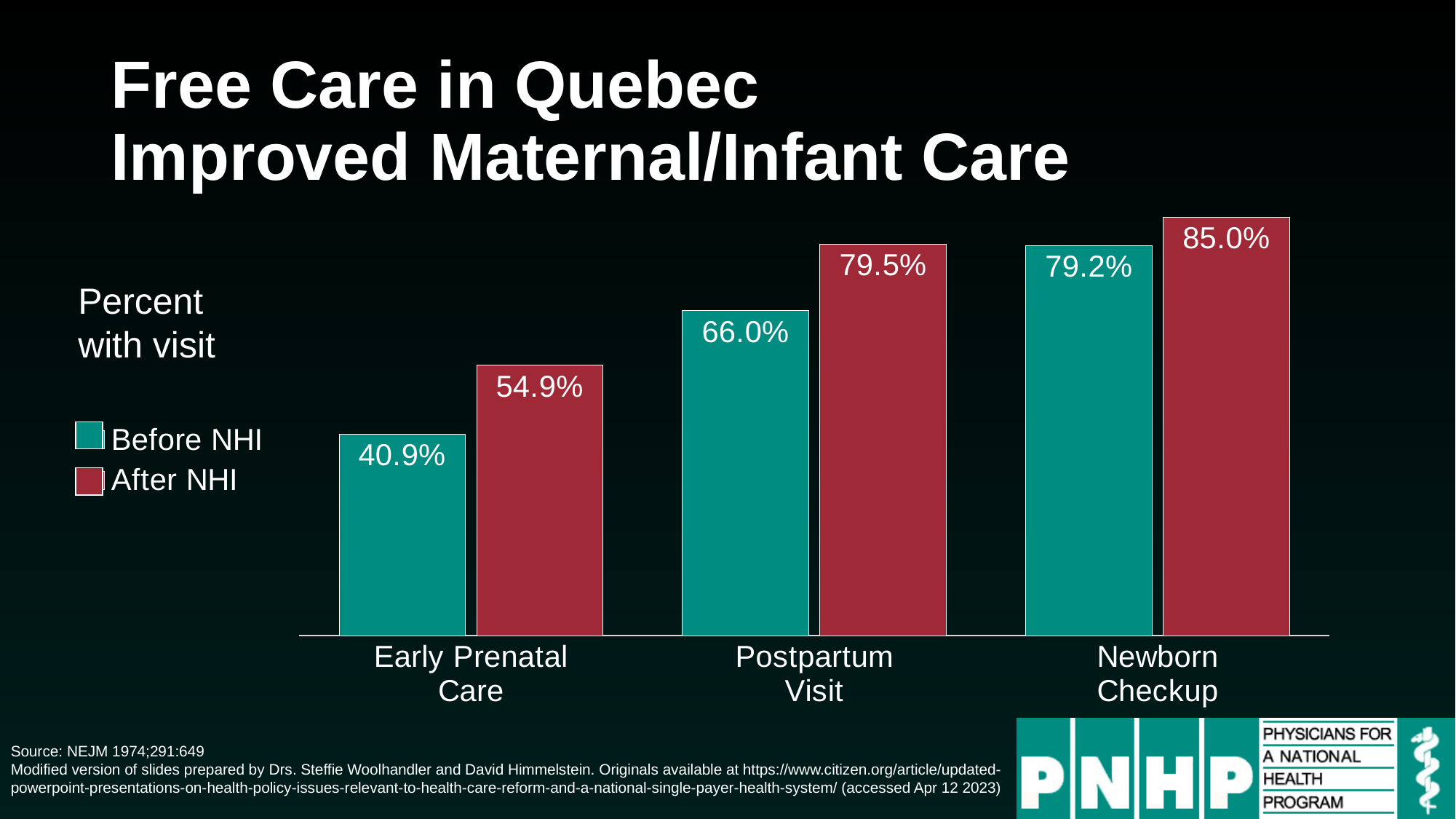
What is the Before NHI value for Early Prenatal Care? 40.9% What is the difference between the After NHI and Before NHI values for Postpartum Visit? 13.5% Which colour represents the After NHI series? Red Which category has the lowest Before NHI value? Early Prenatal Care What is the After NHI value for Postpartum Visit? 79.5% What is the After NHI value for Newborn Checkup? 85.0% Which is larger: the Before NHI value for Newborn Checkup or the After NHI value for Postpartum Visit? After NHI value for Postpartum Visit How many categories are shown on the x axis? 3 What is the difference between the After NHI and Before NHI values for Early Prenatal Care? 14.0% What kind of chart is shown on the slide? Bar chart Which category has the highest After NHI value? Newborn Checkup How many series does the legend list? 2